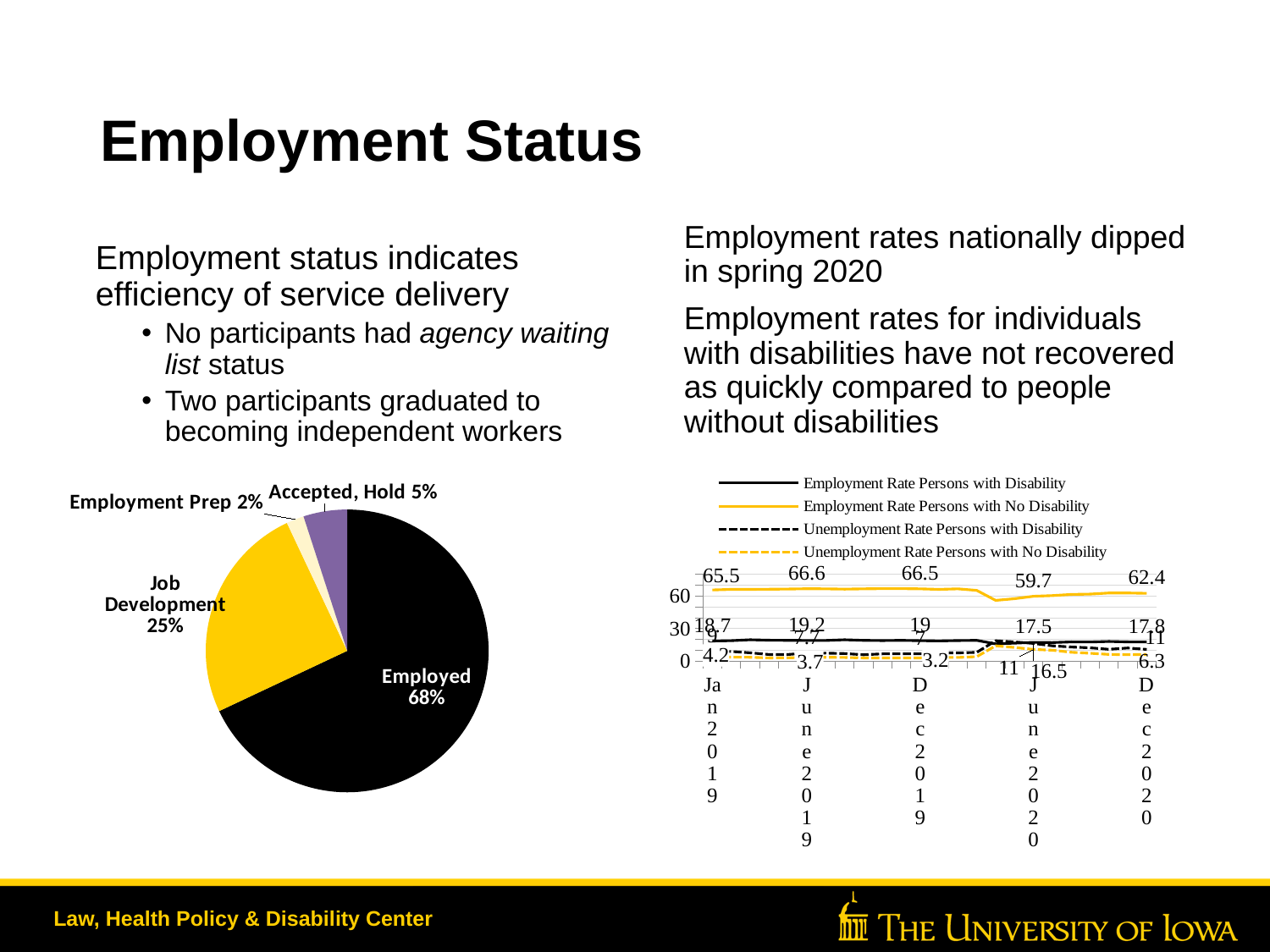
On the pie chart, what is the difference in percentage points between Employed and Job Development? 43 On the pie chart, how many categories are shown? 4 On the line chart, what is the Employment Rate for Persons with Disability in Jan 2019? 18.7 What kind of chart is the chart on the left of the slide? Pie chart On the pie chart, which category has the largest slice? Employed On the line chart, what is the Employment Rate for Persons with No Disability in June 2020? 59.7 On the pie chart, what percentage is shown for Job Development? 25% On the pie chart, which category has the smallest slice? Employment Prep On the pie chart, what share of participants are Employed? 68% On the line chart, how many series does the legend list? 4 On the line chart, which is larger in Dec 2020: the Employment Rate for Persons with Disability or the Employment Rate for Persons with No Disability? Employment Rate Persons with No Disability